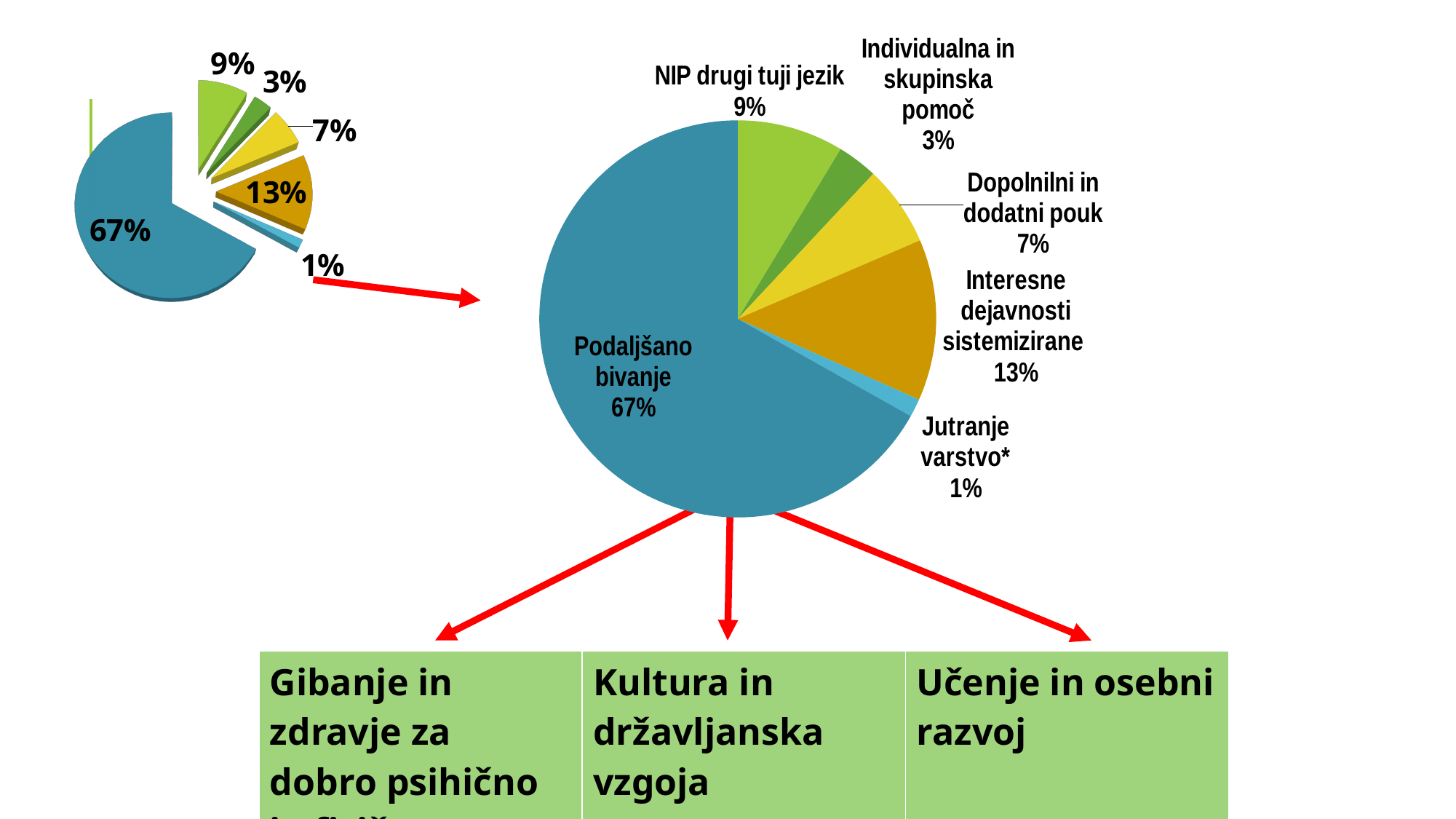
In the large pie chart on the right, which is larger: Dopolnilni in dodatni pouk or Individualna in skupinska pomoč? Dopolnilni in dodatni pouk In the large pie chart on the right, what is the difference in percentage points between Interesne dejavnosti sistemizirane and NIP drugi tuji jezik? 4 In the large pie chart on the right, what share does Podaljšano bivanje have? 67% In the large pie chart on the right, which category has the largest slice? Podaljšano bivanje In the large pie chart on the right, what percentage is shown for Dopolnilni in dodatni pouk? 7% In the large pie chart on the right, what percentage is shown for Jutranje varstvo*? 1% How many slices does the large pie chart on the right have? 6 In the large pie chart on the right, what percentage is shown for NIP drugi tuji jezik? 9% How many pie charts are shown on the slide? 2 In the large pie chart on the right, which category has the smallest slice? Jutranje varstvo* What type of chart is the large chart on the right? Pie chart In the large pie chart on the right, what percentage is shown for Interesne dejavnosti sistemizirane? 13%